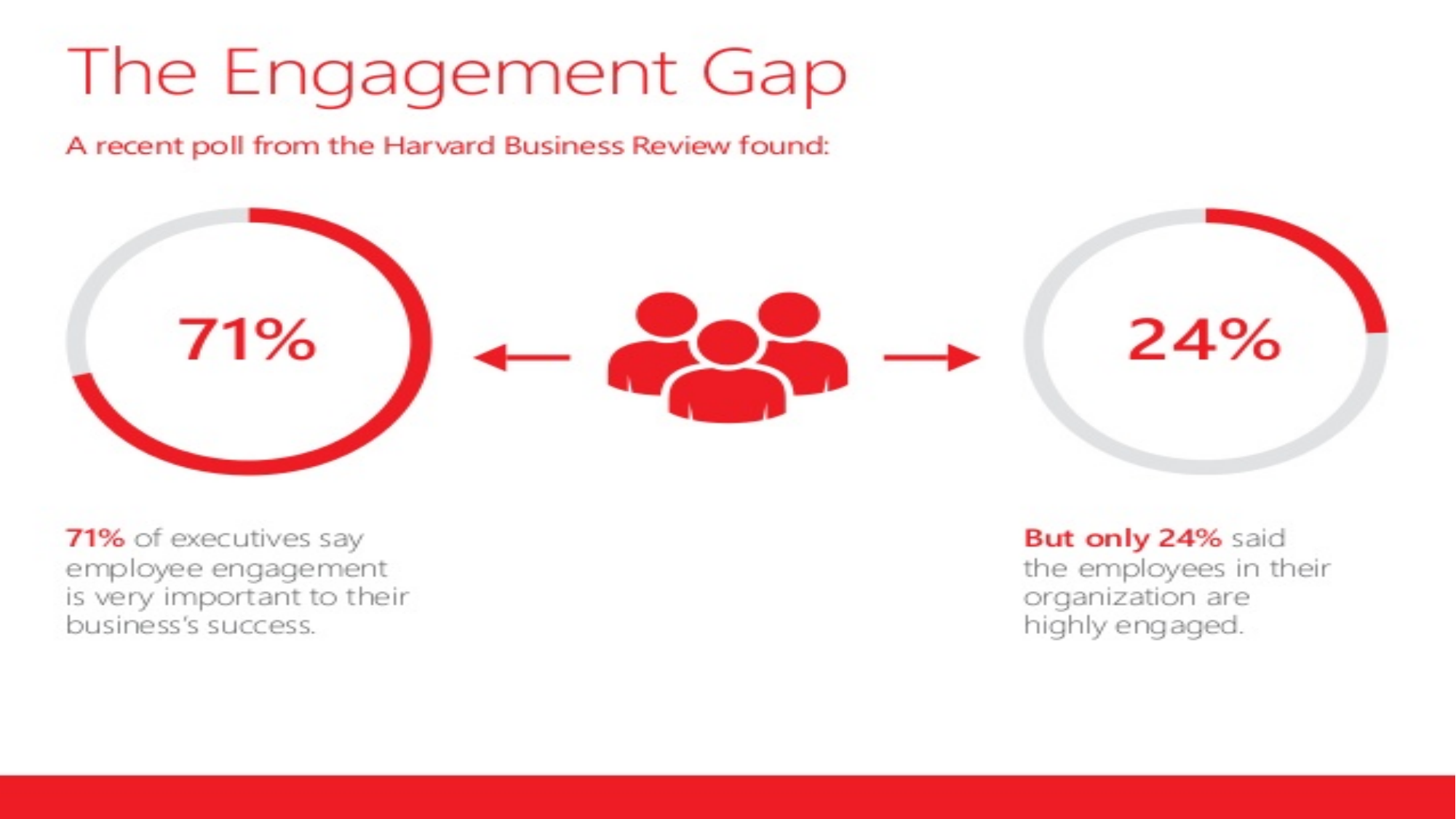
What percentage of executives say employee engagement is very important to their business's success? 71% What value is shown in the right donut chart? 24% What is the difference between the value in the left donut chart and the value in the right donut chart? 47 percentage points What is the title of the slide? The Engagement Gap Which is larger: the value in the left donut chart or the value in the right donut chart? The left donut chart (71%) What percentage said the employees in their organization are highly engaged? 24% Is the value in the right donut chart greater or less than 50%? less What colour is the filled portion of each donut chart? Red What kind of chart is used to show the 71% and 24% values? Donut chart What value is shown in the left donut chart? 71% Is the value in the left donut chart greater or less than 50%? greater How many donut charts are on the slide? 2